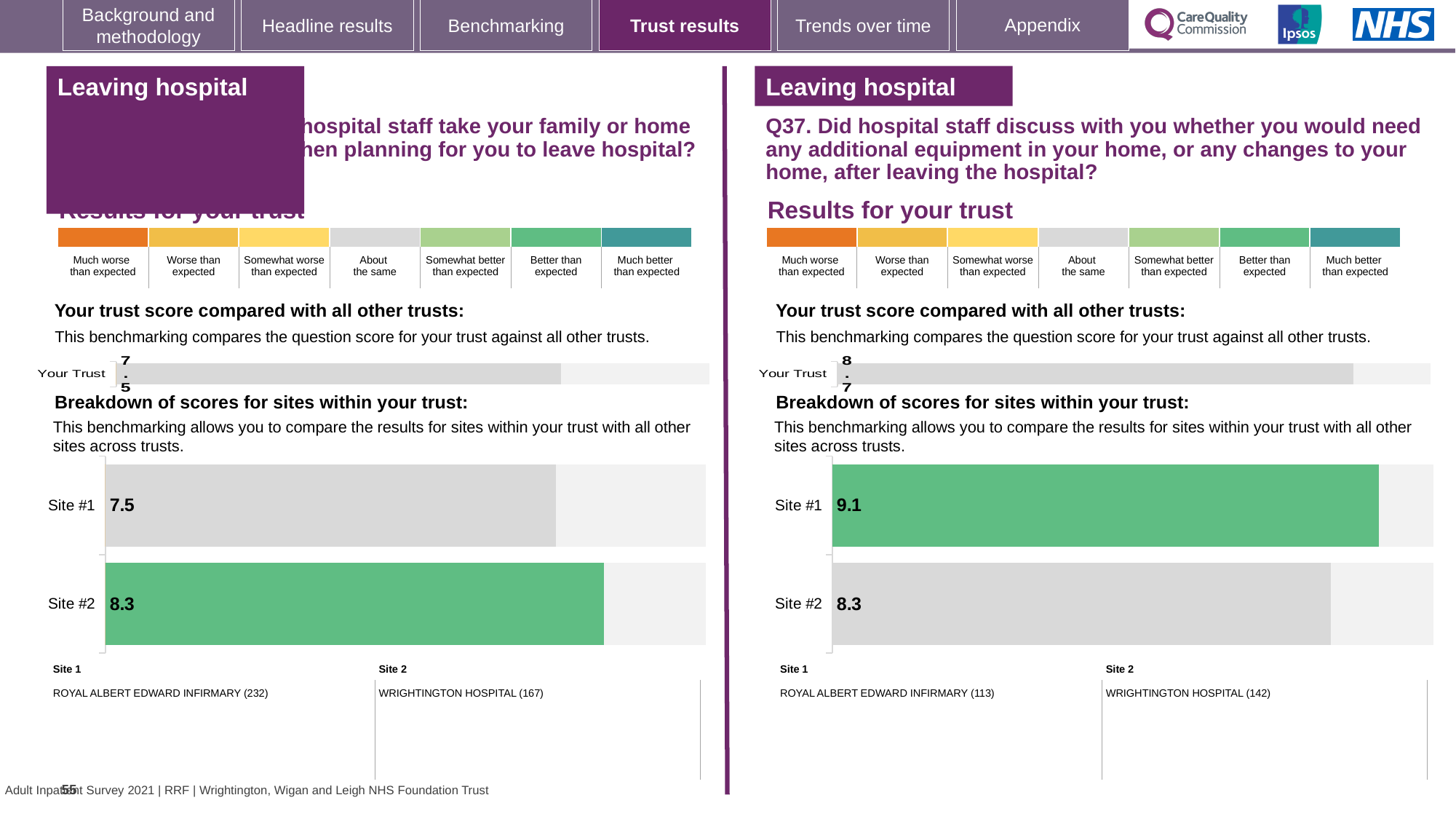
In the left-hand site breakdown chart, which site has the lower score? Site #1 In the right-hand (Q37) site breakdown chart, which site has the higher score? Site #1 In the left-hand site breakdown chart, what is the score for Site #1? 7.5 In the right-hand (Q37) site breakdown chart, what is the score for Site #2? 8.3 In the right-hand (Q37) site breakdown chart, what is the score for Site #1? 9.1 What kind of chart is used for the site breakdown on the right-hand (Q37) side? Bar chart In the left-hand site breakdown chart, what is the score for Site #2? 8.3 How many sites are shown in the right-hand (Q37) site breakdown chart? 2 In the left-hand site breakdown chart, what is the difference between the Site #2 and Site #1 scores? 0.8 In the left-hand 'Your trust score compared with all other trusts' chart, what is the score for Your Trust? 7.5 In the right-hand (Q37) 'Your trust score compared with all other trusts' chart, what is the score for Your Trust? 8.7 In the right-hand (Q37) site breakdown chart, what is the difference between the Site #1 and Site #2 scores? 0.8